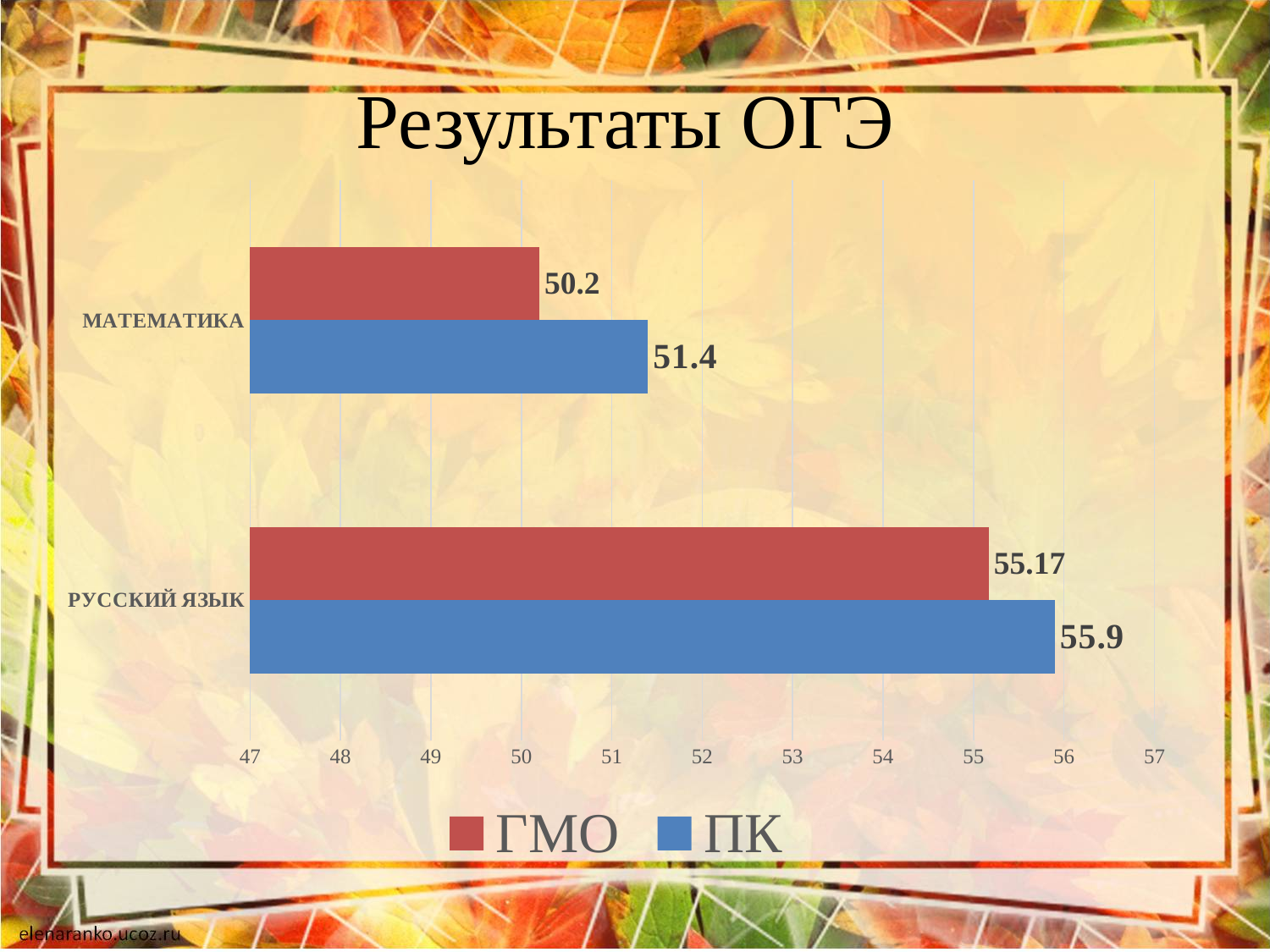
What kind of chart is shown on the slide? bar chart Which category has the lowest ГМО value? МАТЕМАТИКА What is the ПК value for МАТЕМАТИКА? 51.4 Which is larger for РУССКИЙ ЯЗЫК, the ГМО value or the ПК value? ПК What is the ГМО value for МАТЕМАТИКА? 50.2 Is the ГМО value for РУССКИЙ ЯЗЫК greater or less than 54? greater What is the difference between the ПК and ГМО values for МАТЕМАТИКА? 1.2 What is the ПК value for РУССКИЙ ЯЗЫК? 55.9 What is the ГМО value for РУССКИЙ ЯЗЫК? 55.17 How many categories are shown on the chart? 2 Which category has the highest ПК value? РУССКИЙ ЯЗЫК How many series does the legend list? 2